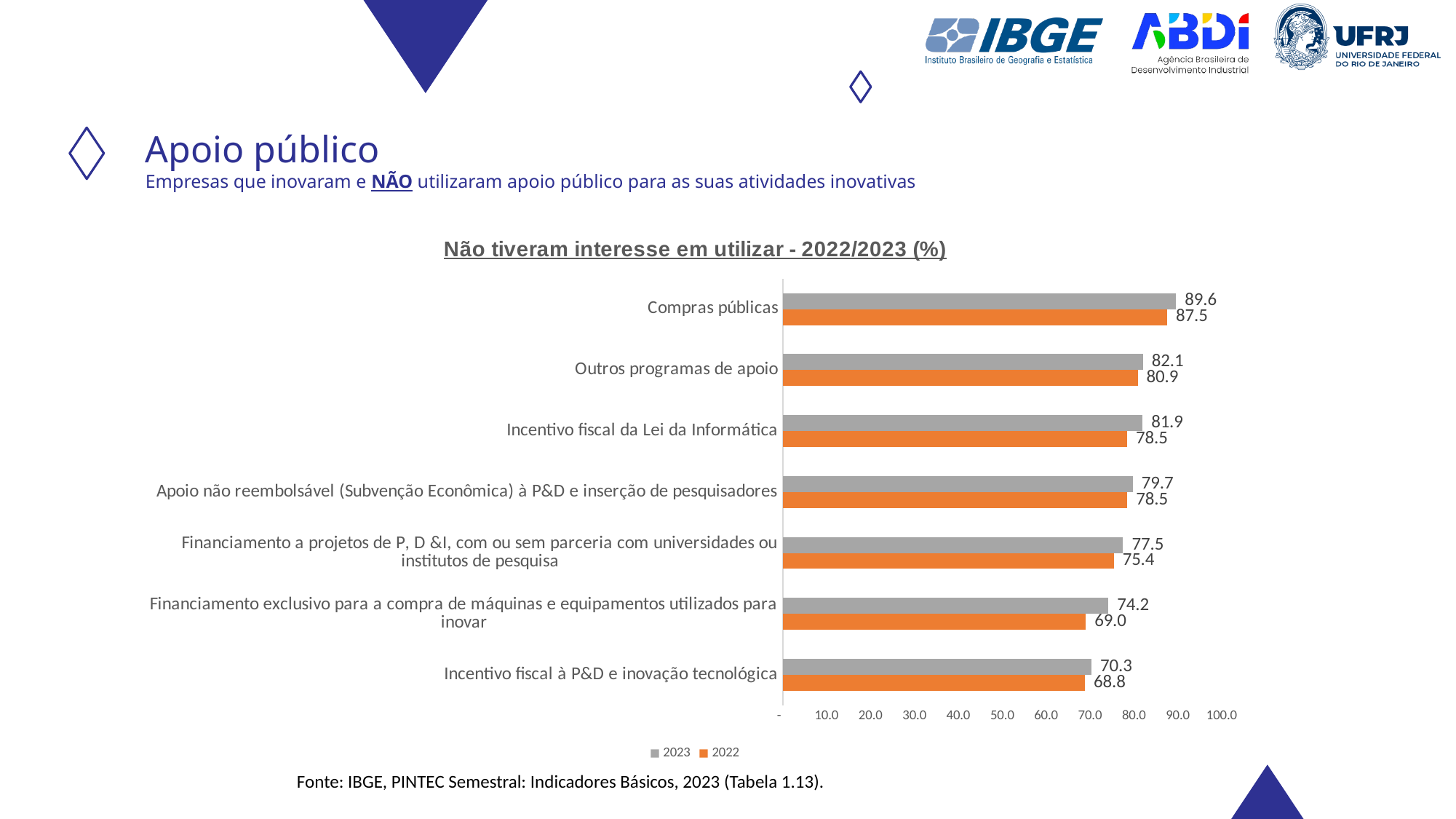
Which category has the lowest 2022 value? Incentivo fiscal à P&D e inovação tecnológica What is the 2022 value for Financiamento exclusivo para a compra de máquinas e equipamentos utilizados para inovar? 69.0 Which category has the highest 2023 value? Compras públicas Which is larger: the 2023 value for Outros programas de apoio or the 2023 value for Incentivo fiscal da Lei da Informática? Outros programas de apoio What is the difference between the 2023 values for Compras públicas and Outros programas de apoio? 7.5 What is the title of the chart? Não tiveram interesse em utilizar - 2022/2023 (%) What is the difference between the 2023 and 2022 values for Financiamento exclusivo para a compra de máquinas e equipamentos utilizados para inovar? 5.2 What is the 2023 value for Compras públicas? 89.6 What is the 2022 value for Incentivo fiscal da Lei da Informática? 78.5 What kind of chart is shown on the slide? Bar chart How many categories are shown in the chart? 7 How many series does the legend list? 2